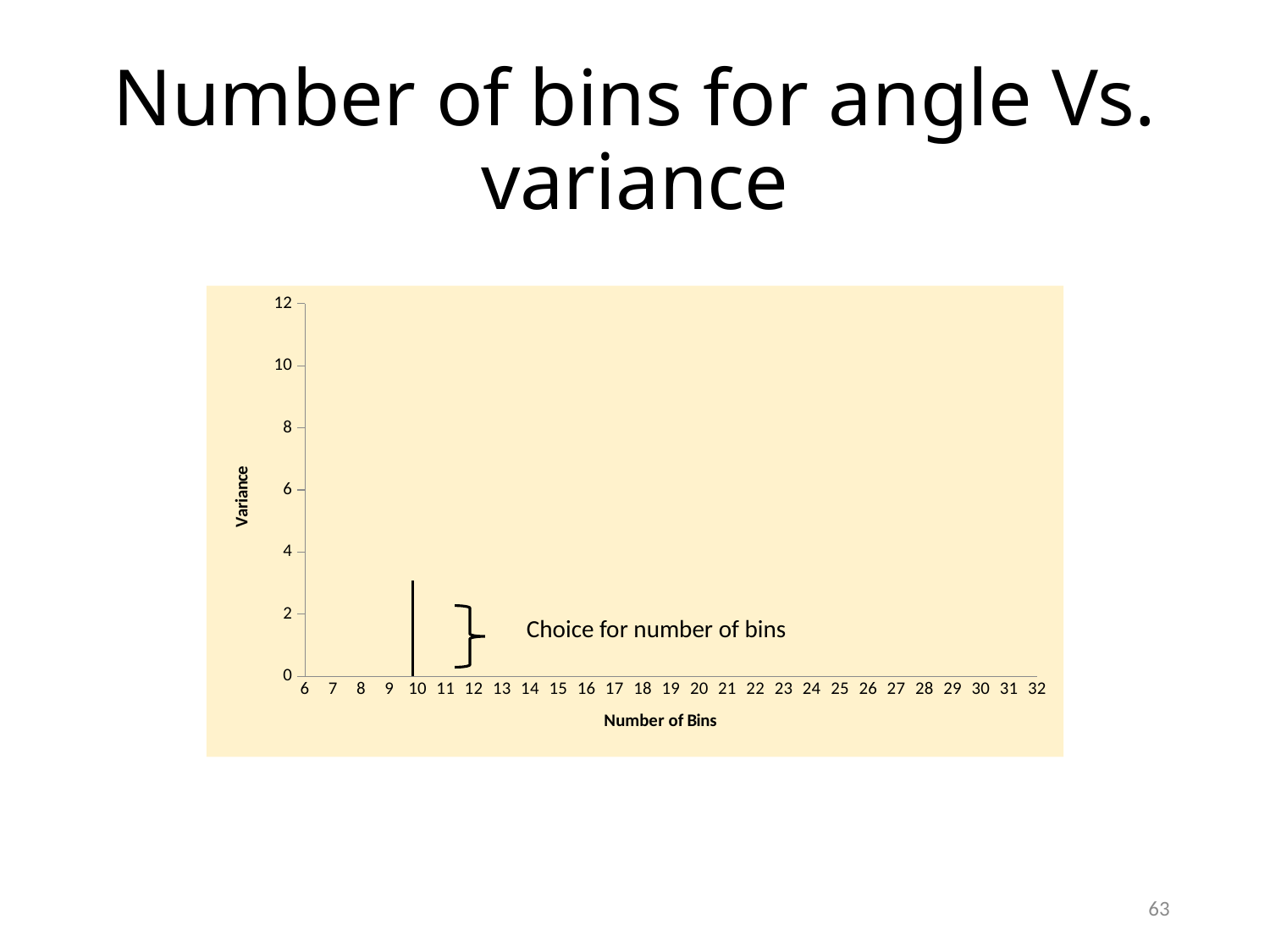
What is the label of the y axis on the chart? Variance How many tick labels are shown along the x axis of the chart? 27 What is the largest number of bins shown on the x axis of the chart? 32 What is the label of the x axis on the chart? Number of Bins What is the highest value shown on the y axis of the chart? 12 What is the smallest number of bins shown on the x axis of the chart? 6